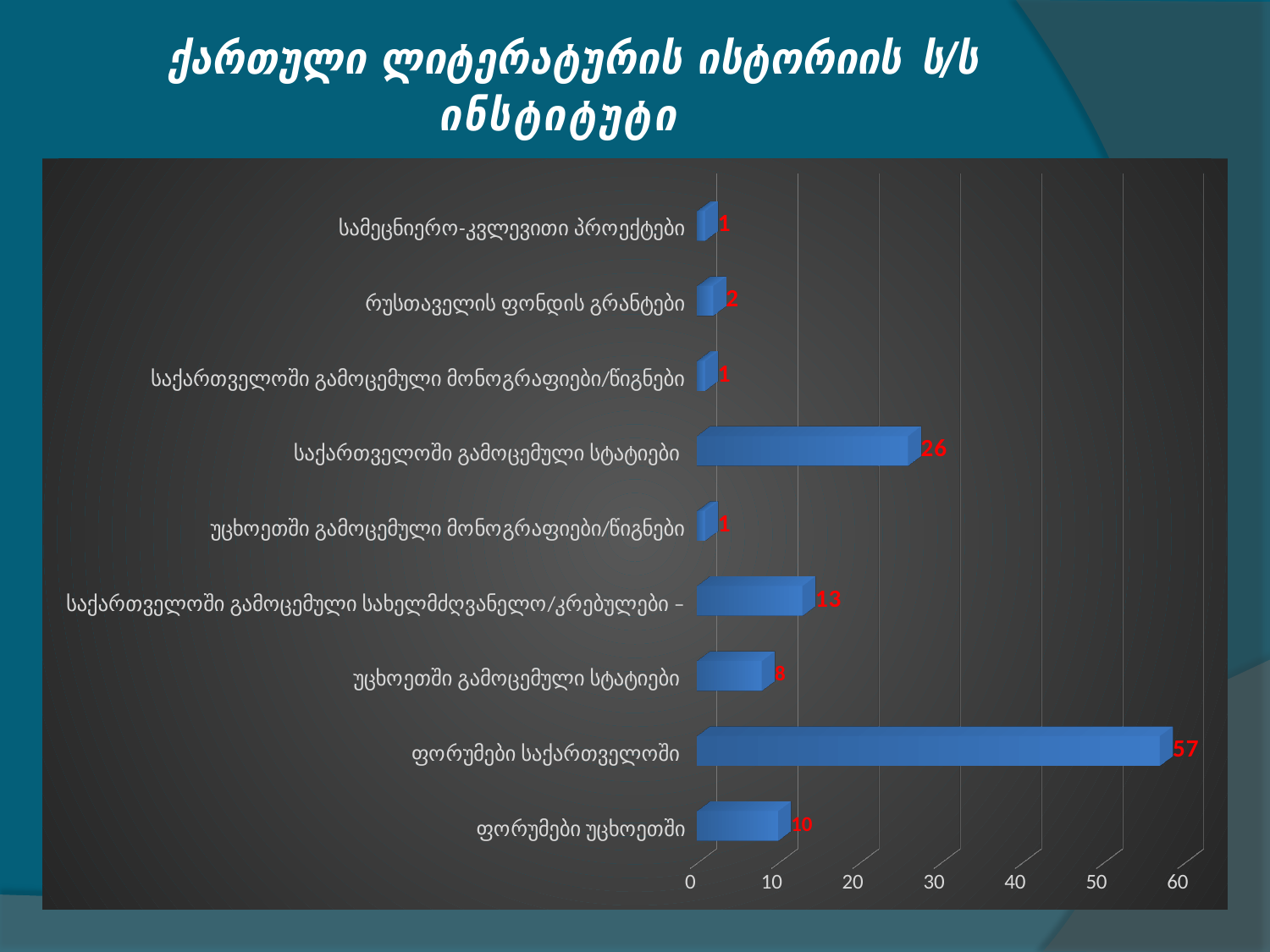
Is the value for ფორუმები საქართველოში greater or less than 50? greater What is the title of the slide? ქართული ლიტერატურის ისტორიის ს/ს ინსტიტუტი What is the value for საქართველოში გამოცემული სტატიები? 26 How many categories are plotted in the chart? 9 What is the value for უცხოეთში გამოცემული სტატიები? 8 What is the value for ფორუმები საქართველოში? 57 What is the value for რუსთაველის ფონდის გრანტები? 2 Which is larger: საქართველოში გამოცემული სახელმძღვანელო/კრებულები or ფორუმები უცხოეთში? საქართველოში გამოცემული სახელმძღვანელო/კრებულები What is the difference between საქართველოში გამოცემული სტატიები and უცხოეთში გამოცემული სტატიები? 18 What is the difference between ფორუმები საქართველოში and ფორუმები უცხოეთში? 47 What type of chart is shown on the slide? bar chart Which category has the highest value? ფორუმები საქართველოში